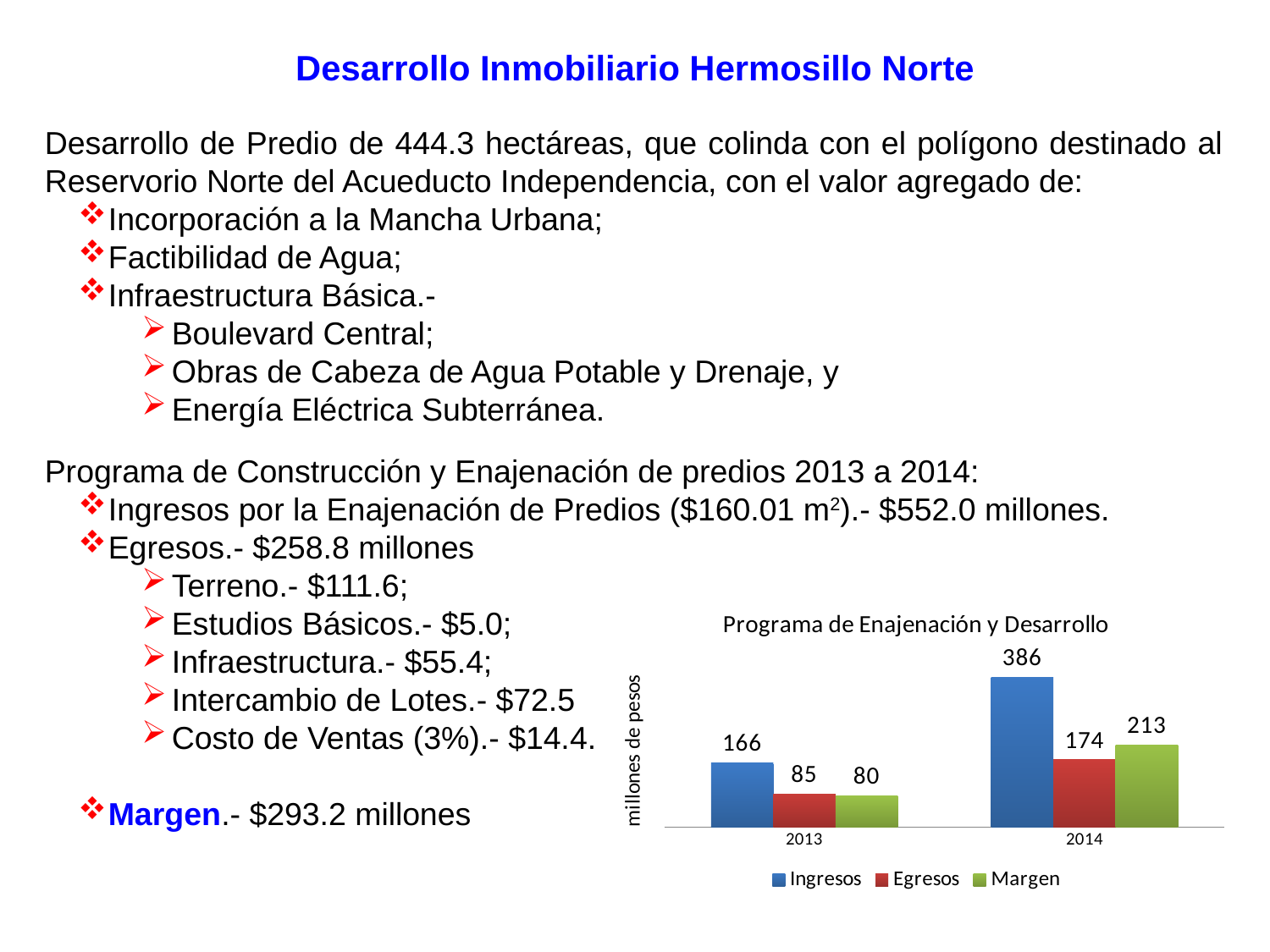
What is the title of the chart? Programa de Enajenación y Desarrollo What is the value of Margen for 2013? 80 How many series does the legend list? 3 What is the difference between Ingresos in 2014 and Ingresos in 2013? 220 Which is larger, Egresos in 2013 or Margen in 2013? Egresos in 2013 What is the value of Ingresos for 2013? 166 What is the value of Egresos for 2014? 174 What kind of chart is shown on the slide? Bar chart Which series has the lowest value in 2013? Margen How many years are shown on the x axis of the chart? 2 Which year has the highest Ingresos value? 2014 What is the difference between Margen in 2014 and Egresos in 2014? 39